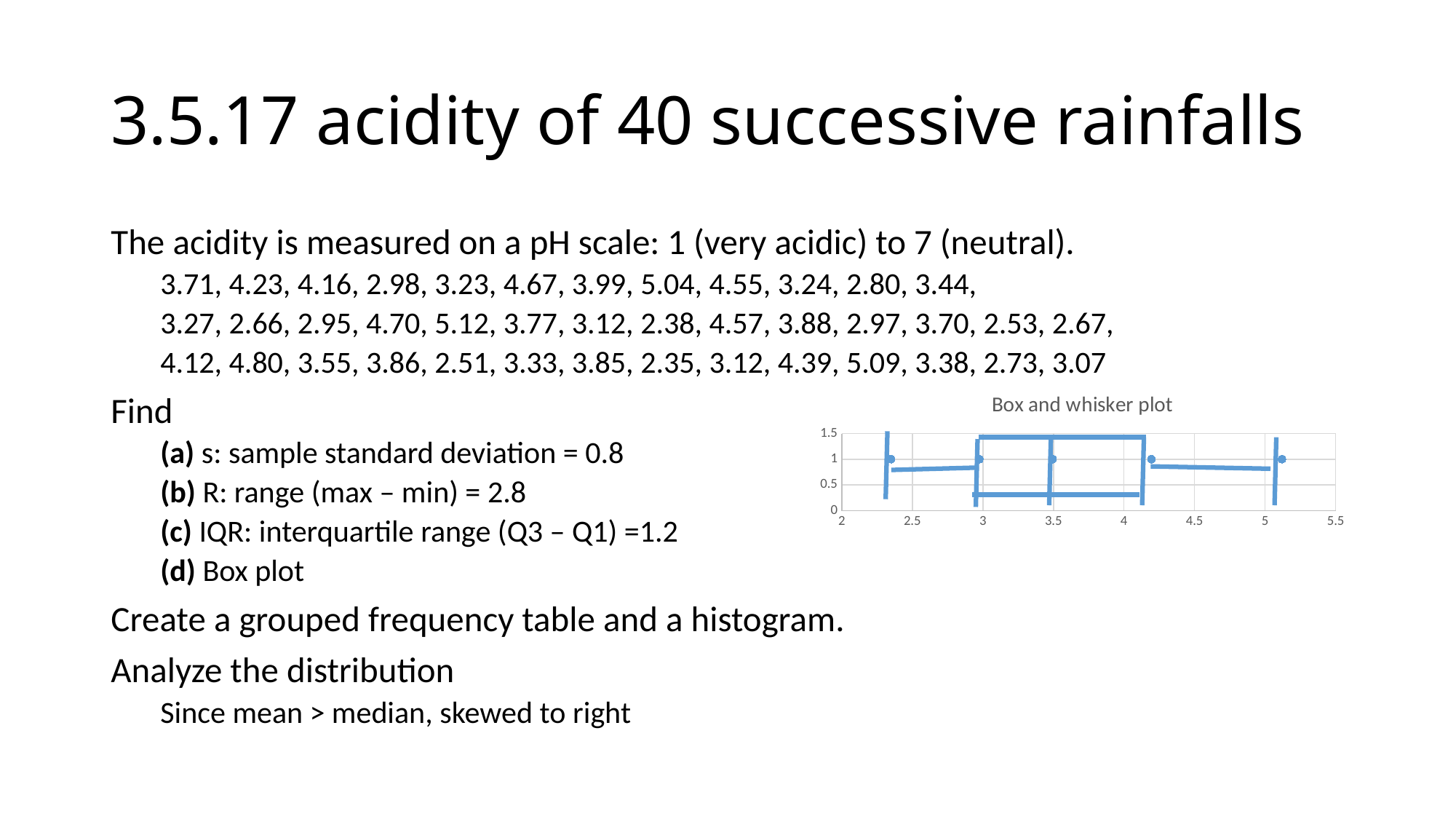
How many tick labels are shown on the x axis of the box and whisker plot? 8 What is the lowest value labelled on the x axis of the box and whisker plot? 2 What kind of chart is shown on the slide? Box and whisker plot In the box and whisker plot, is the left edge of the box (Q1) greater or less than 2.5? greater In the box and whisker plot, is the median line greater or less than 4? less In the box and whisker plot, is the highest whisker end (maximum) greater or less than 5? greater What is the title of the chart on the slide? Box and whisker plot